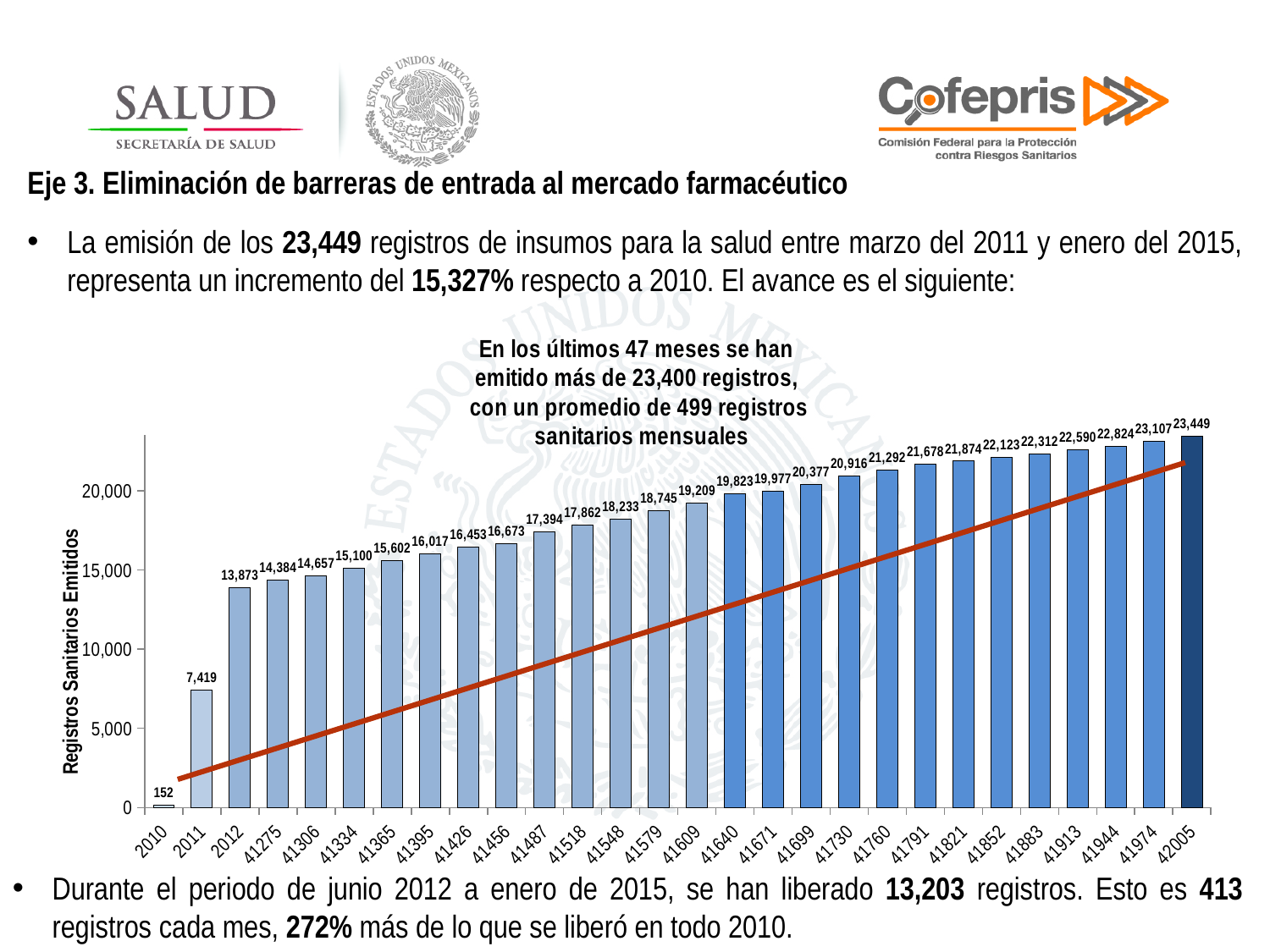
Which category has the lowest value? 2010 What is the value for the category labelled 42005? 23,449 What is the difference between the values for 2012 and 2011? 6,454 What is the value for 2012? 13,873 Which is larger, the value for 41275 or the value for 41306? 41306 Which category has the highest value? 42005 How many bars are plotted in the chart? 28 What is the value for the category labelled 41640? 19,823 What is the value for 2011? 7,419 What is the title of the vertical axis? Registros Sanitarios Emitidos What is the value for 2010? 152 What type of chart is shown on the slide? bar chart